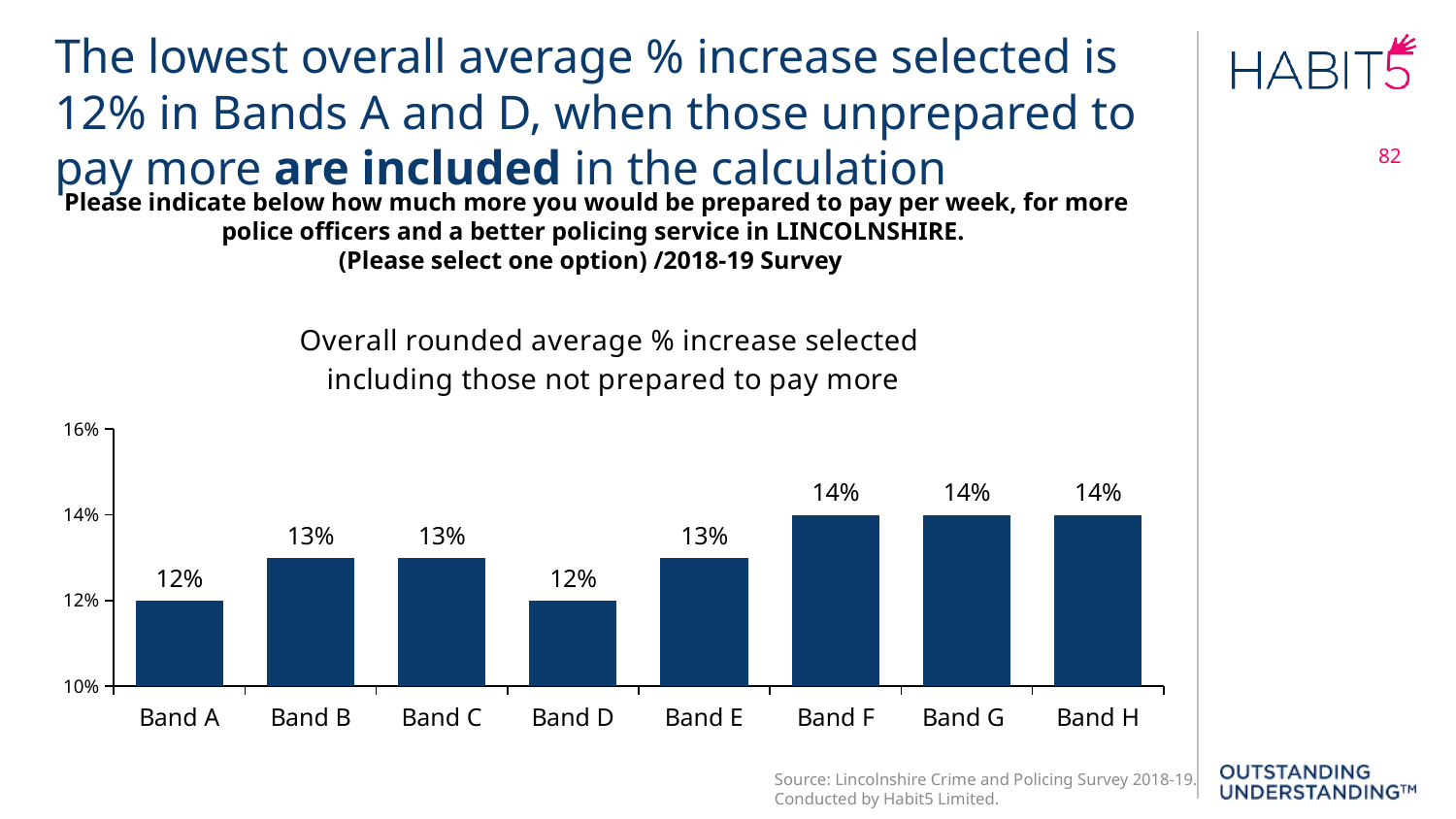
What is the overall rounded average % increase selected for Band E? 13% What is the highest overall rounded average % increase shown on the chart? 14% How many bands are shown on the x axis of the chart? 8 What is the overall rounded average % increase selected for Band A? 12% What is the overall rounded average % increase selected for Band G? 14% Which bands share the lowest overall rounded average % increase? Band A and Band D Do the values generally rise or fall from Band E to Band H? Rise Which has a larger value, Band B or Band D? Band B What is the title of the chart? Overall rounded average % increase selected including those not prepared to pay more What kind of chart is shown on the slide? Bar chart What is the difference between the values for Band F and Band A? 2% Is the value for Band H greater or less than 12%? greater